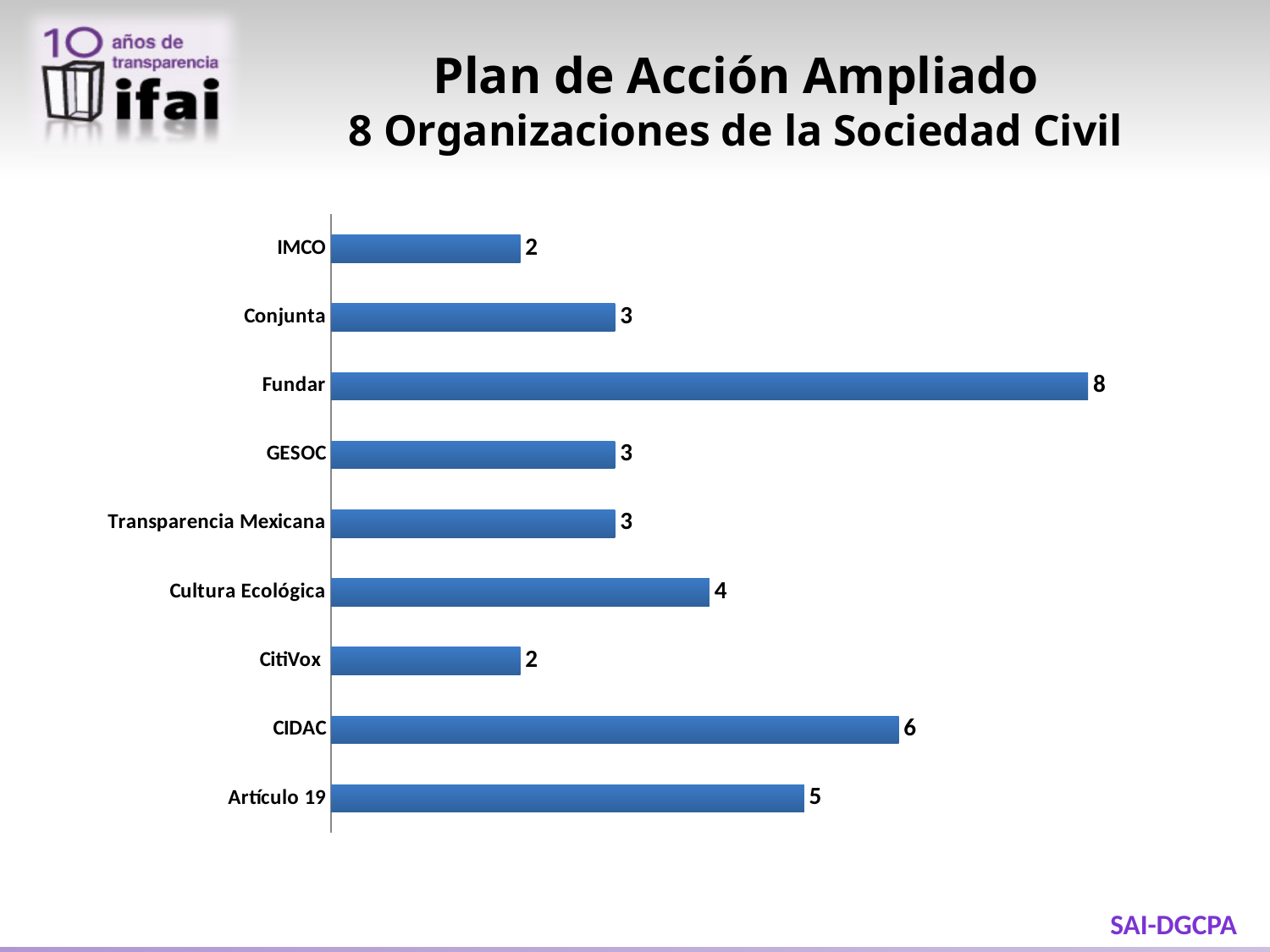
Which is larger, the value for CIDAC or the value for Cultura Ecológica? CIDAC What is the value for Cultura Ecológica? 4 What is the value for Artículo 19? 5 What is the value for CIDAC? 6 What is the difference between the values for Fundar and CIDAC? 2 How many organizations are shown in the chart? 9 What is the difference between the values for Artículo 19 and IMCO? 3 What is the title of the slide? Plan de Acción Ampliado 8 Organizaciones de la Sociedad Civil What kind of chart is shown on the slide? Bar chart Which organization has the highest value? Fundar What is the value for Transparencia Mexicana? 3 What is the value for Fundar? 8